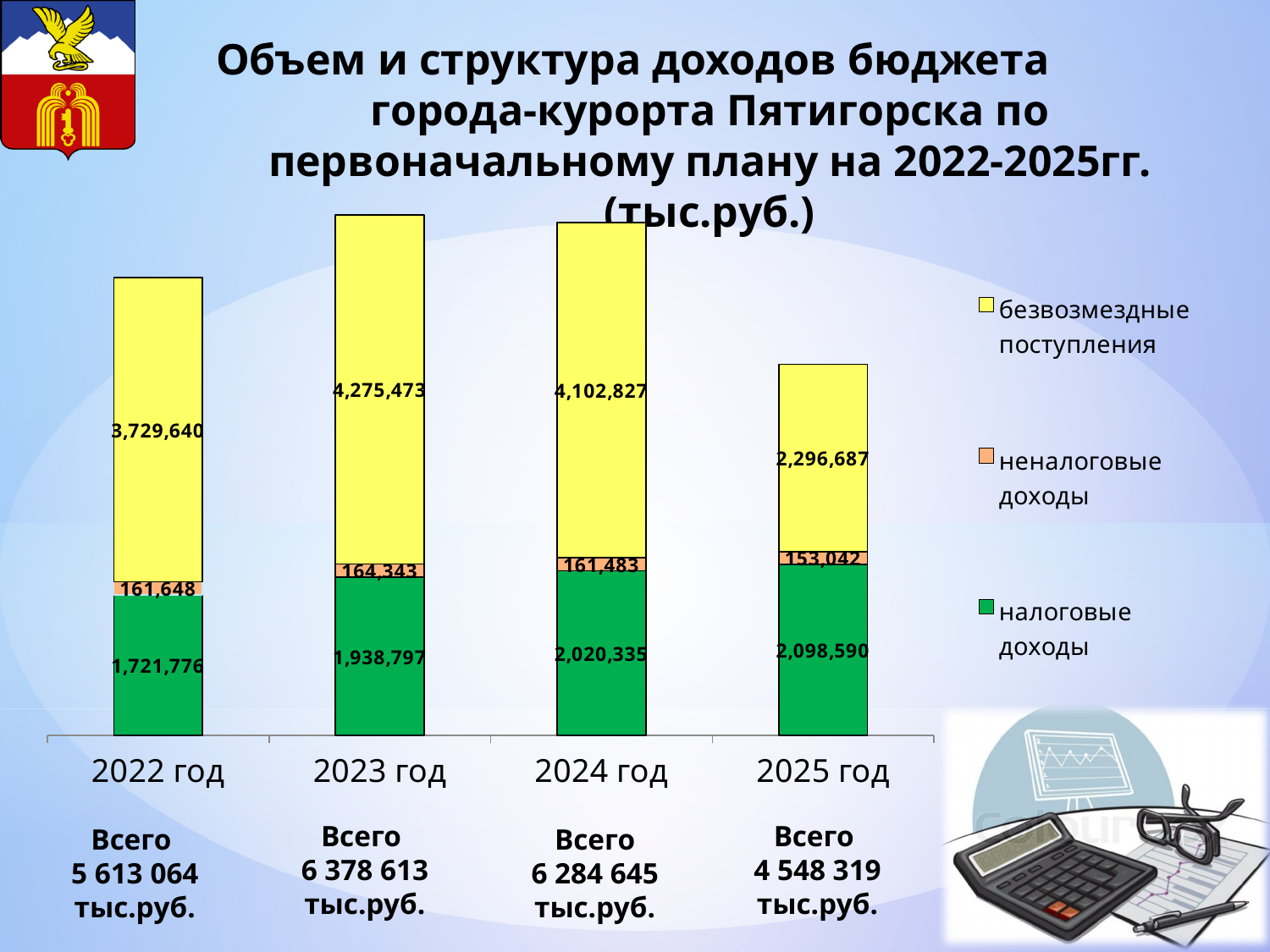
How many series does the legend list? 3 Which is larger: безвозмездные поступления in 2024 год or in 2025 год? 2024 год In which year is the value of налоговые доходы the lowest? 2022 год What is the value of безвозмездные поступления for 2023 год? 4,275,473 How many years (categories) are shown on the x axis? 4 What is the value of налоговые доходы for 2022 год? 1,721,776 What type of chart is shown on the slide? stacked bar chart What is the total budget income (Всего) for 2024 год? 6 284 645 тыс.руб. In which year is the value of безвозмездные поступления the highest? 2023 год What is the value of неналоговые доходы for 2025 год? 153,042 Do the values of налоговые доходы rise or fall from 2022 год to 2025 год? rise What is the difference between налоговые доходы in 2025 год and 2024 год? 78,255